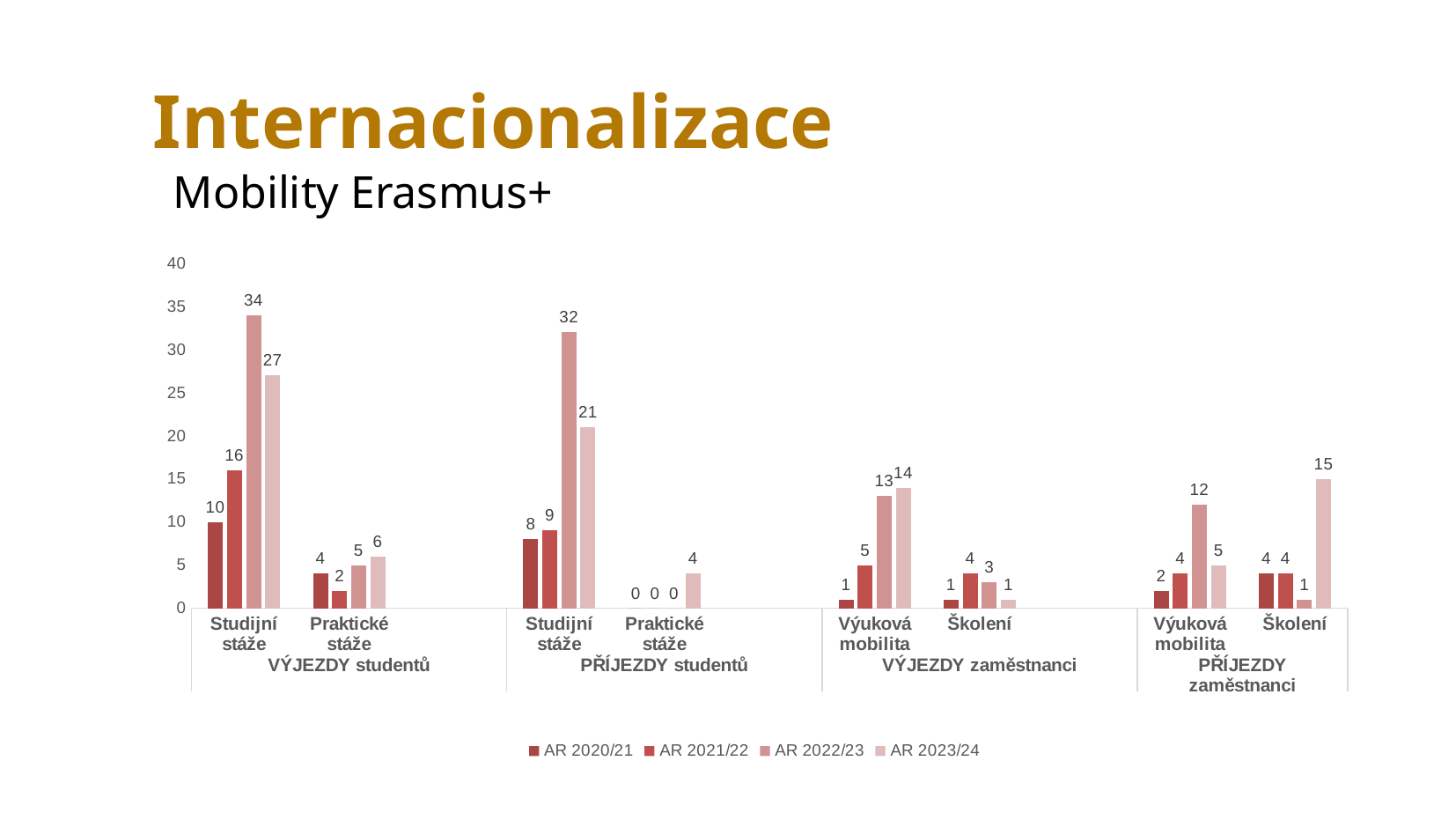
What is the value for AR 2022/23 for Studijní stáže under VÝJEZDY studentů? 34 What is the subtitle of the chart shown on the slide? Mobility Erasmus+ What is the difference between the AR 2022/23 and AR 2023/24 values for Studijní stáže under PŘÍJEZDY studentů? 11 Which series has the highest value for Studijní stáže under VÝJEZDY studentů? AR 2022/23 How many series does the legend list? 4 What is the value for AR 2023/24 for Školení under PŘÍJEZDY zaměstnanci? 15 Which is larger for Výuková mobilita under PŘÍJEZDY zaměstnanci: AR 2022/23 or AR 2023/24? AR 2022/23 What kind of chart is shown on the slide? Bar chart What is the value for AR 2021/22 for Výuková mobilita under VÝJEZDY zaměstnanci? 5 Which series has the lowest value for Praktické stáže under VÝJEZDY studentů? AR 2021/22 What is the value for AR 2023/24 for Studijní stáže under PŘÍJEZDY studentů? 21 What is the total of the four series values for Praktické stáže under PŘÍJEZDY studentů? 4